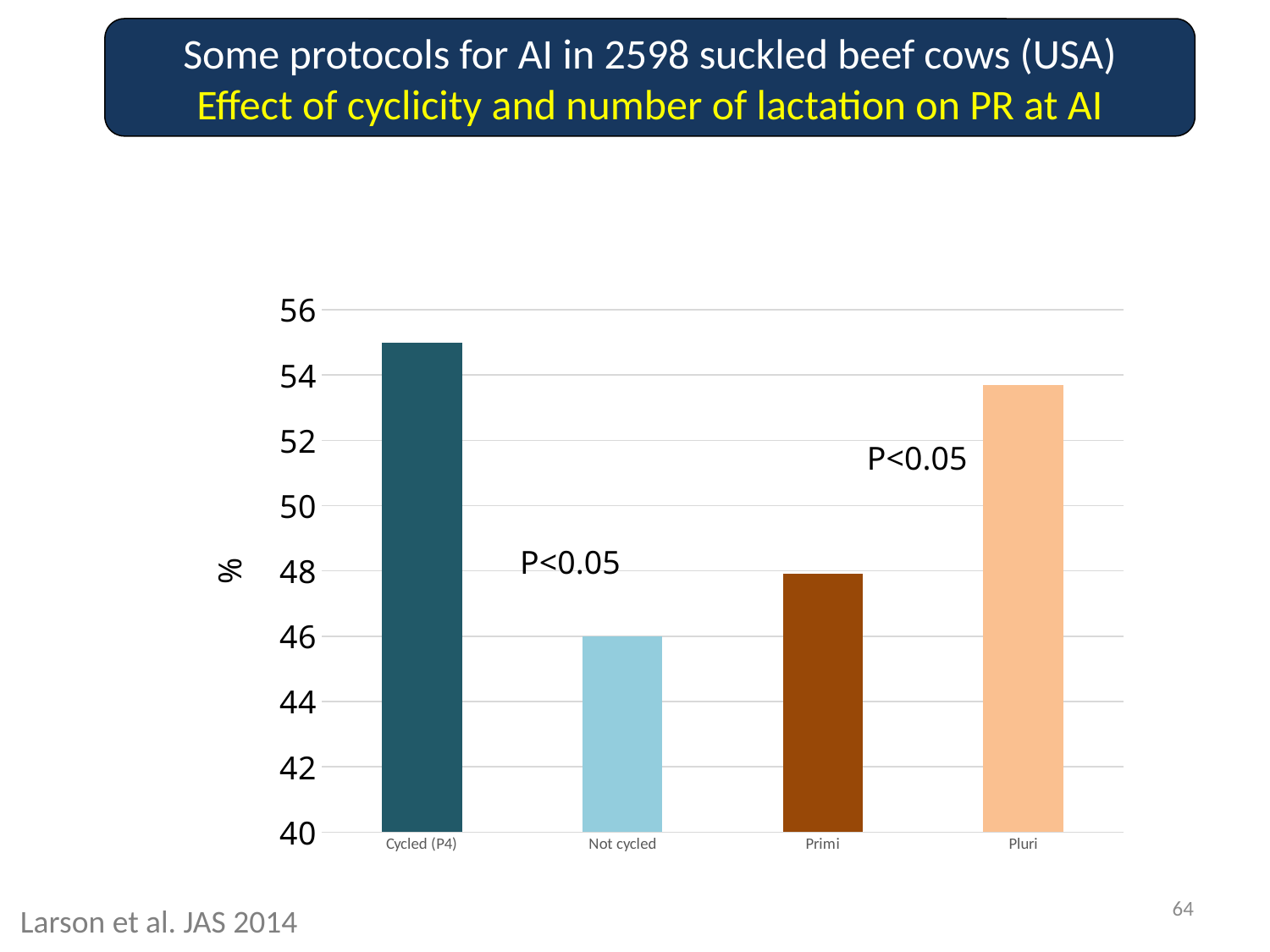
Is the value for Cycled (P4) greater or less than 54? greater Which is larger, the value for Cycled (P4) or the value for Not cycled? Cycled (P4) Is the value for Pluri greater or less than 52? greater Which category has the lowest value? Not cycled What is the label on the y axis of the chart? % What source is cited at the bottom of the slide? Larson et al. JAS 2014 What kind of chart is shown on the slide? bar chart Is the value for Primi greater or less than 50? less Which is larger, the value for Primi or the value for Pluri? Pluri Which category has the highest value? Cycled (P4) How many categories are plotted on the x axis? 4